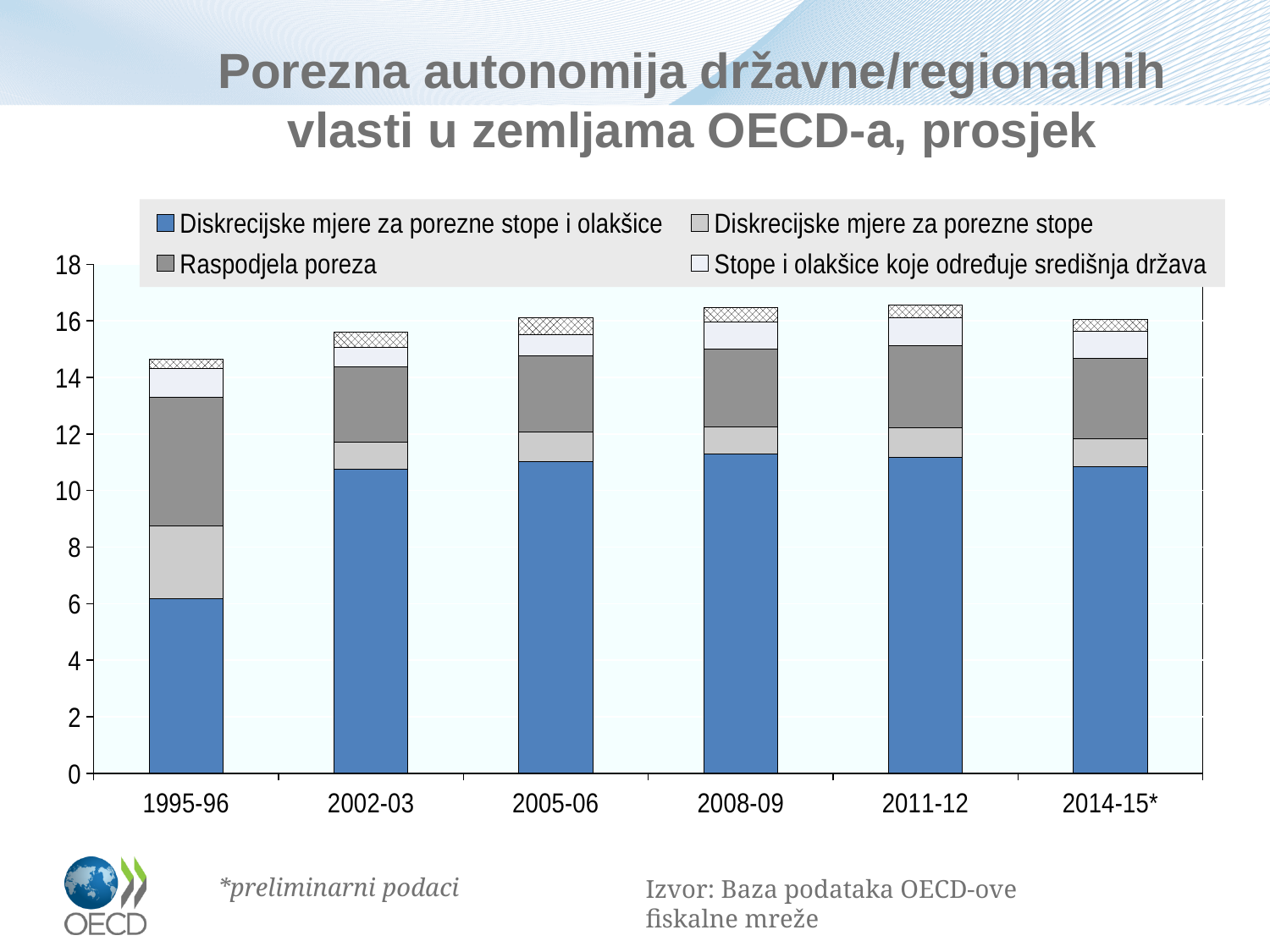
How many series does the chart's legend list? 4 Is the total bar height for 2011-12 greater or less than 16? greater Is the value for 'Diskrecijske mjere za porezne stope i olakšice' in 2002-03 greater or less than 10? greater Which period has the smallest value for 'Diskrecijske mjere za porezne stope i olakšice'? 1995-96 Which is larger, the 'Diskrecijske mjere za porezne stope i olakšice' value for 1995-96 or for 2002-03? 2002-03 Is the total bar height for 1995-96 greater or less than 16? less How many time periods are shown on the x axis of the chart? 6 Which period has the lowest total bar height? 1995-96 Does the total bar height rise or fall from 1995-96 to 2011-12? Rises What kind of chart is shown on the slide? Stacked bar chart Which legend entry is shown with the solid blue colour? Diskrecijske mjere za porezne stope i olakšice